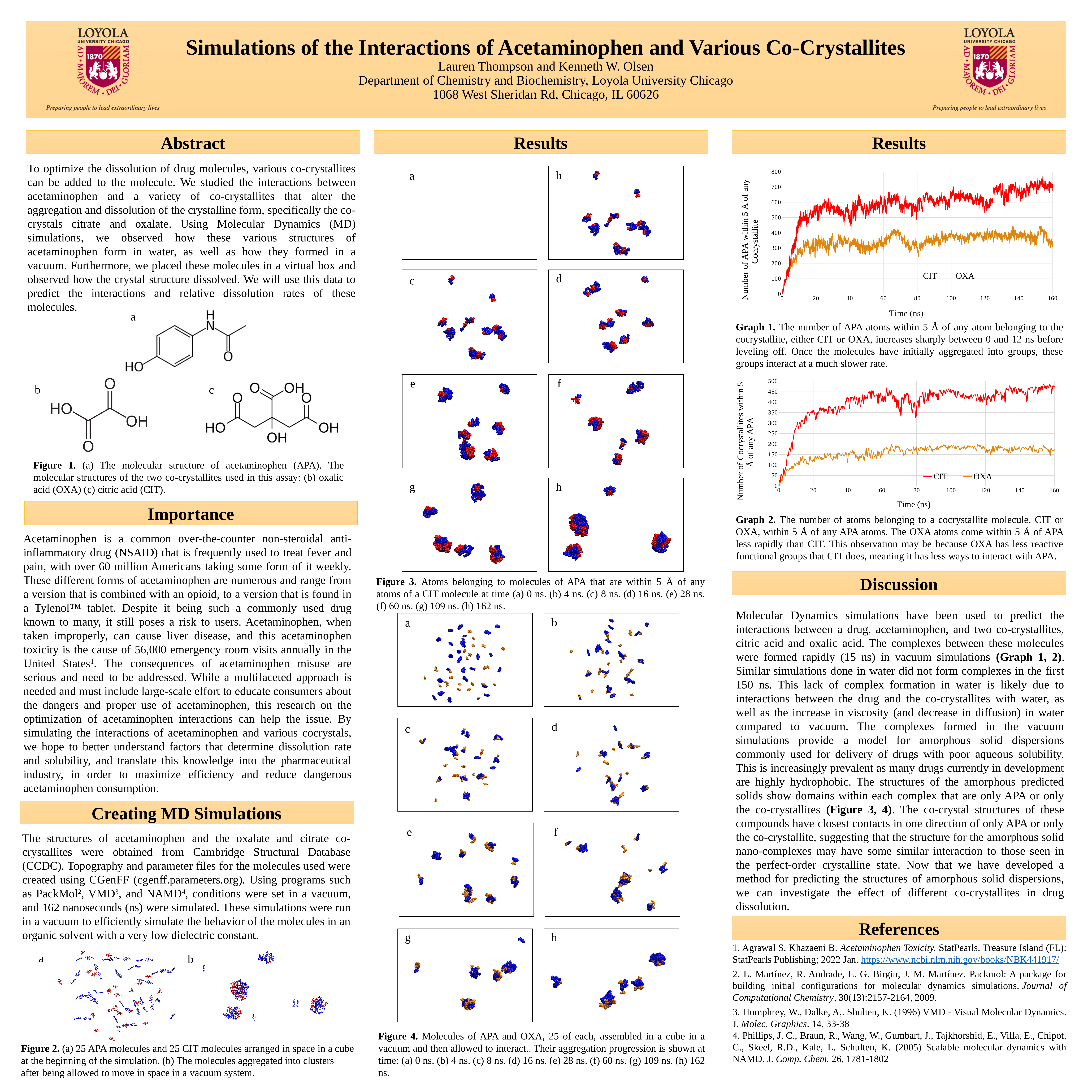
In Graph 1, which series has the higher value at 160 ns, CIT or OXA? CIT How many series does the legend of Graph 1 list? 2 In Graph 2, which series has the lower value at 160 ns, CIT or OXA? OXA In Graph 1, is the value for OXA at 100 ns greater or less than 500? less In Graph 2, is the value for CIT at 160 ns greater or less than 400? greater What kind of chart is Graph 1? line chart In Graph 1, does the CIT series generally rise or fall between 0 and 160 ns? rise What is the maximum value shown on the y-axis of Graph 2? 500 In Graph 1, is the value for CIT at 160 ns greater or less than 600? greater What are the two series named in the legend of Graph 2? CIT and OXA What is the x-axis title of Graph 1? Time (ns)